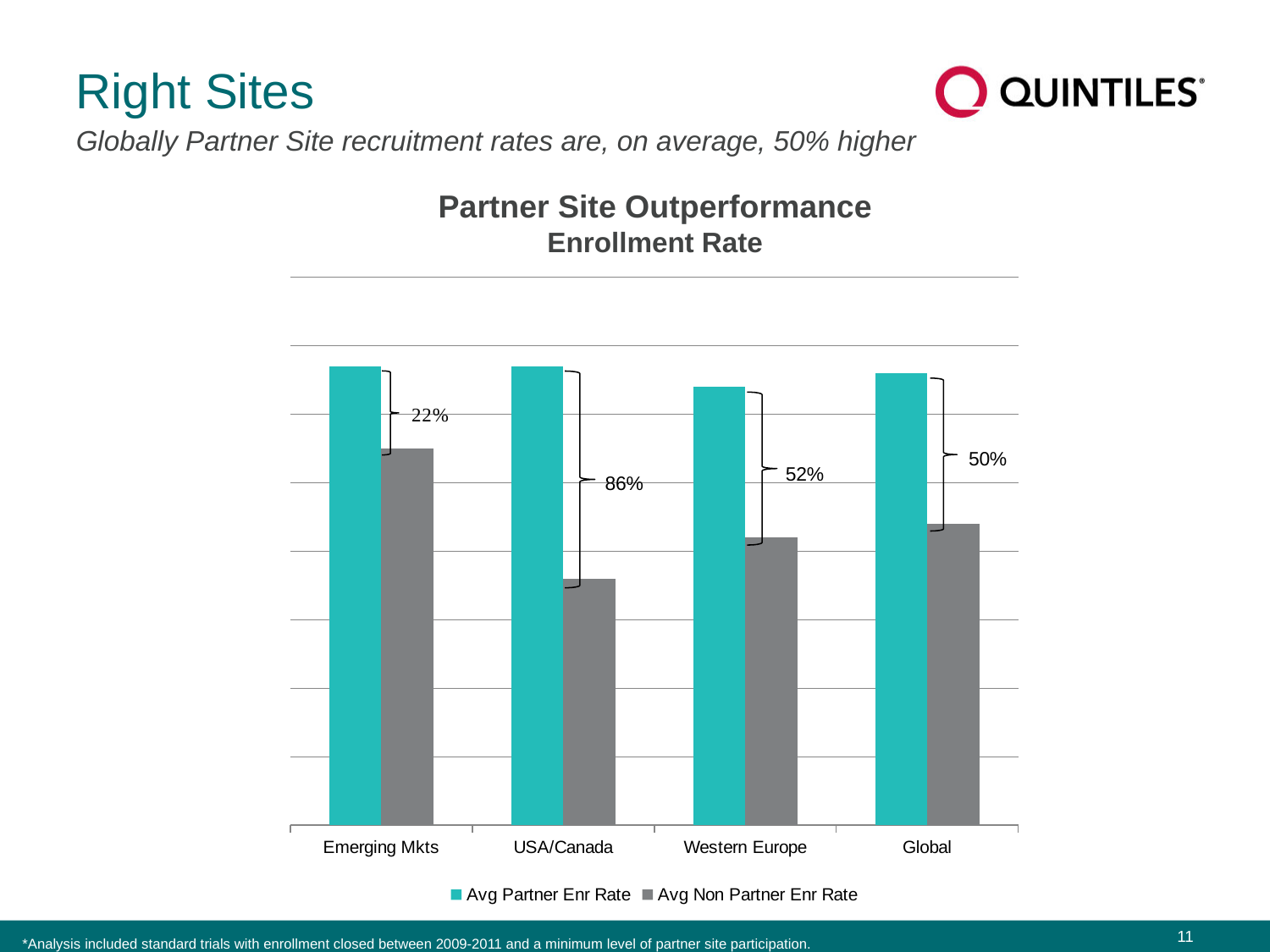
Which region has the smallest annotated outperformance percentage? Emerging Mkts How many regions (categories) are shown on the x axis of the chart? 4 Which region has the largest annotated outperformance percentage? USA/Canada What outperformance percentage is annotated for Western Europe? 52% For USA/Canada, which is larger: the Avg Partner Enr Rate or the Avg Non Partner Enr Rate? Avg Partner Enr Rate What outperformance percentage is annotated for Global? 50% What outperformance percentage is annotated for Emerging Mkts? 22% How many series does the chart's legend list? 2 What is the title of the chart? Partner Site Outperformance Enrollment Rate Which region has the lowest Avg Non Partner Enr Rate bar? USA/Canada What outperformance percentage is annotated for USA/Canada? 86% What kind of chart is shown on the slide? bar chart